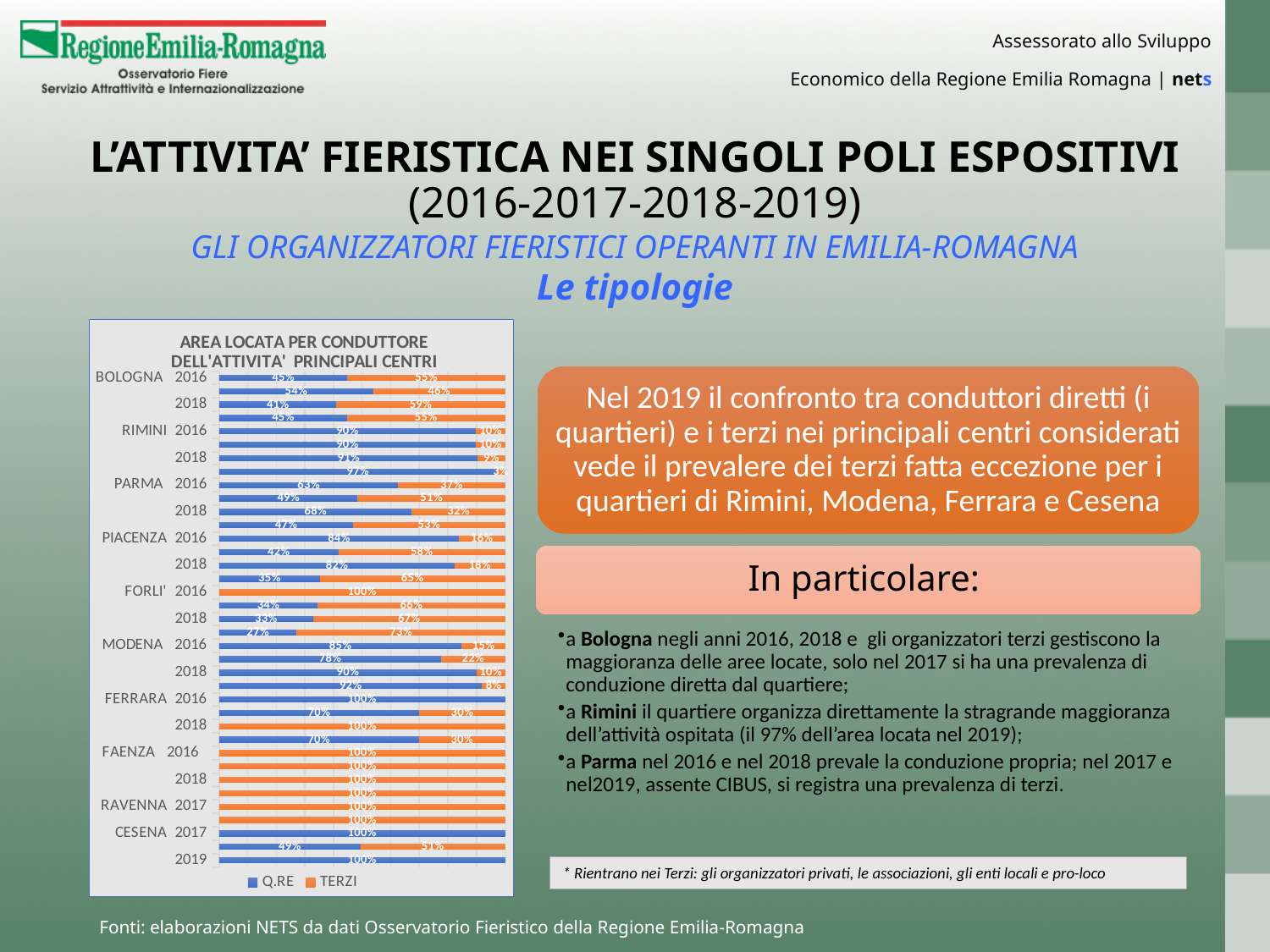
What is the difference between the Q.RE and TERZI values for Parma in 2018? 36% What kind of chart is shown on the slide? Stacked horizontal bar chart What is the TERZI value for Parma in 2016? 37% What is the Q.RE value for Bologna in 2016? 45% What is the TERZI value for Bologna in 2018? 59% What is the Q.RE value for Cesena in 2019? 100% What are the two series named in the chart legend? Q.RE and TERZI What is the TERZI value for Faenza in 2016? 100% Which series is larger for Modena in 2016, Q.RE or TERZI? Q.RE What is the Q.RE value for Rimini in 2018? 91% How many series does the chart legend list? 2 What is the Q.RE value for Piacenza in 2018? 82%